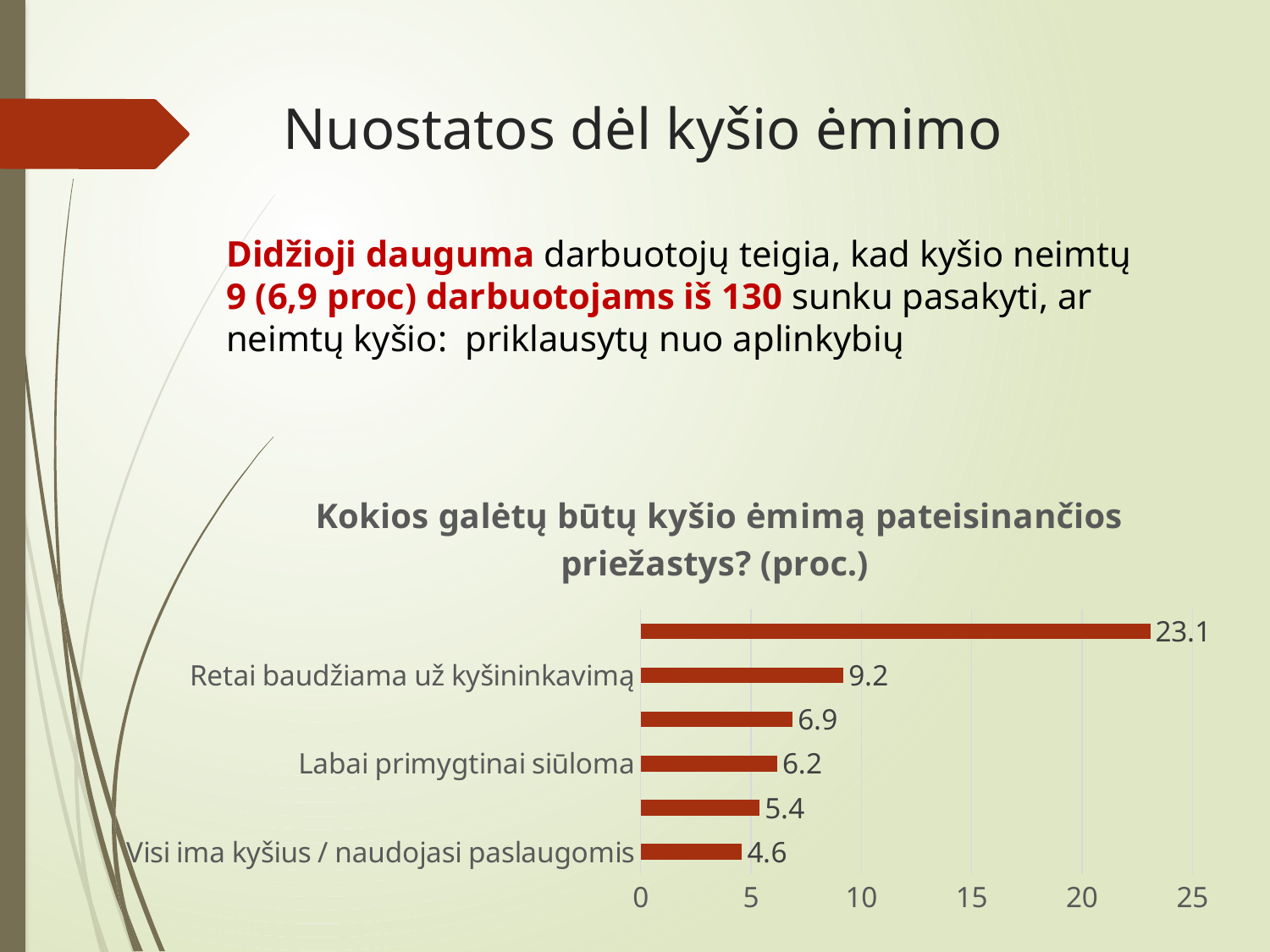
What kind of chart is shown on the slide? bar chart Which category has the lowest value in the chart? Visi ima kyšius / naudojasi paslaugomis What is the largest value shown in the chart? 23.1 What is the title of the chart? Kokios galėtų būtų kyšio ėmimą pateisinančios priežastys? (proc.) What is the difference between the values for "Retai baudžiama už kyšininkavimą" and "Visi ima kyšius / naudojasi paslaugomis"? 4.6 Is the value for "Retai baudžiama už kyšininkavimą" greater or less than 10? less What is the difference between the values for "Retai baudžiama už kyšininkavimą" and "Labai primygtinai siūloma"? 3.0 How many bars are plotted in the chart? 6 What is the value for "Retai baudžiama už kyšininkavimą"? 9.2 Which is larger, the value for "Labai primygtinai siūloma" or the value for "Visi ima kyšius / naudojasi paslaugomis"? Labai primygtinai siūloma What is the value for "Labai primygtinai siūloma"? 6.2 What is the value for "Visi ima kyšius / naudojasi paslaugomis"? 4.6